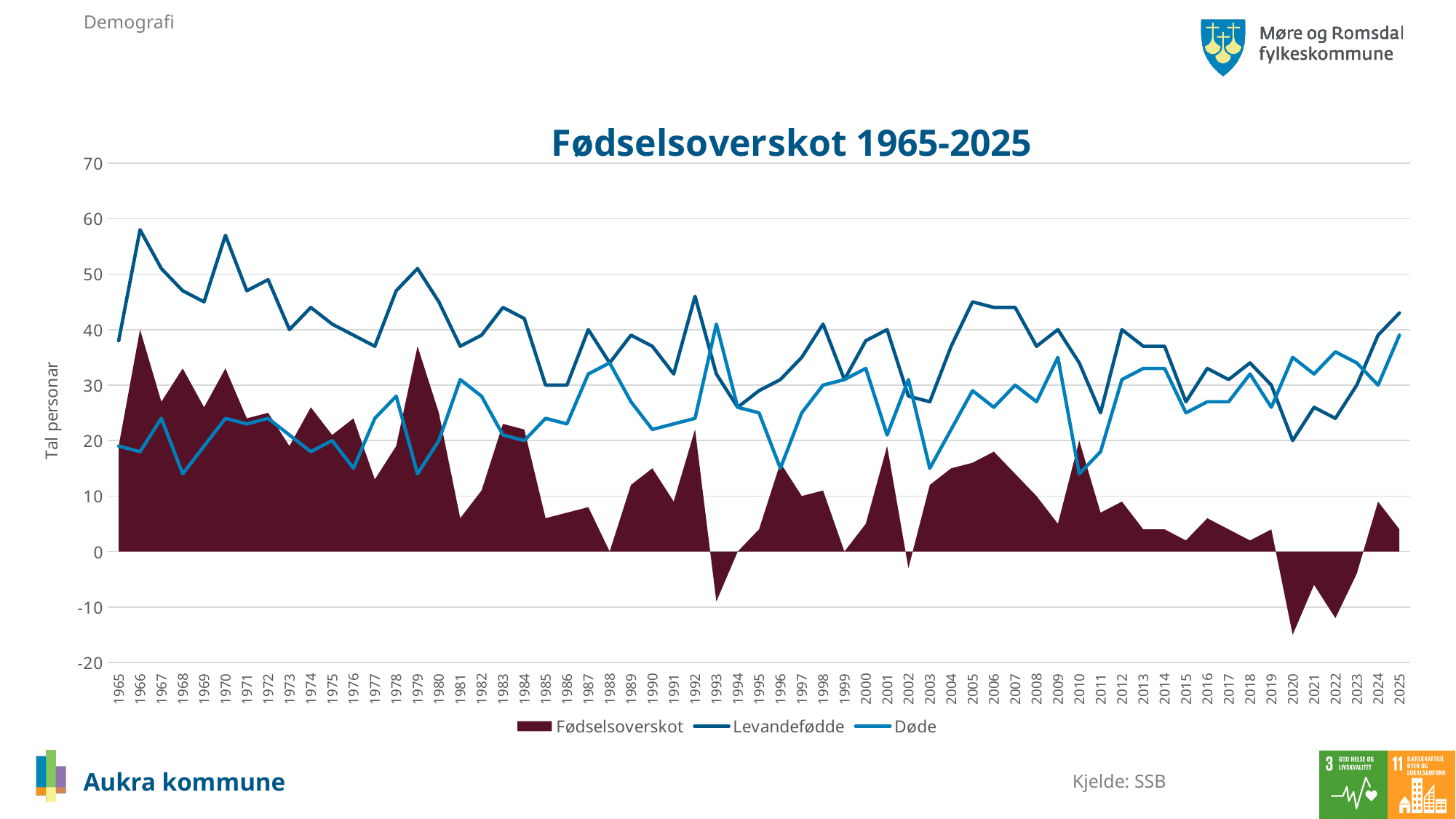
What is the title of the chart? Fødselsoverskot 1965-2025 What is the label on the vertical axis? Tal personar Is the value for Døde in 1968 greater or less than 20? less In which year is Fødselsoverskot at its lowest? 2020 Is the value for Fødselsoverskot in 2020 greater or less than -10? less Is the value for Fødselsoverskot in 1993 greater or less than 0? less How many years are plotted along the x axis? 61 Does the Døde series generally rise or fall from 1965 to 2025? rise How many series does the legend list? 3 In 2020, which is larger, Levandefødde or Døde? Døde In which year is Levandefødde at its lowest? 2020